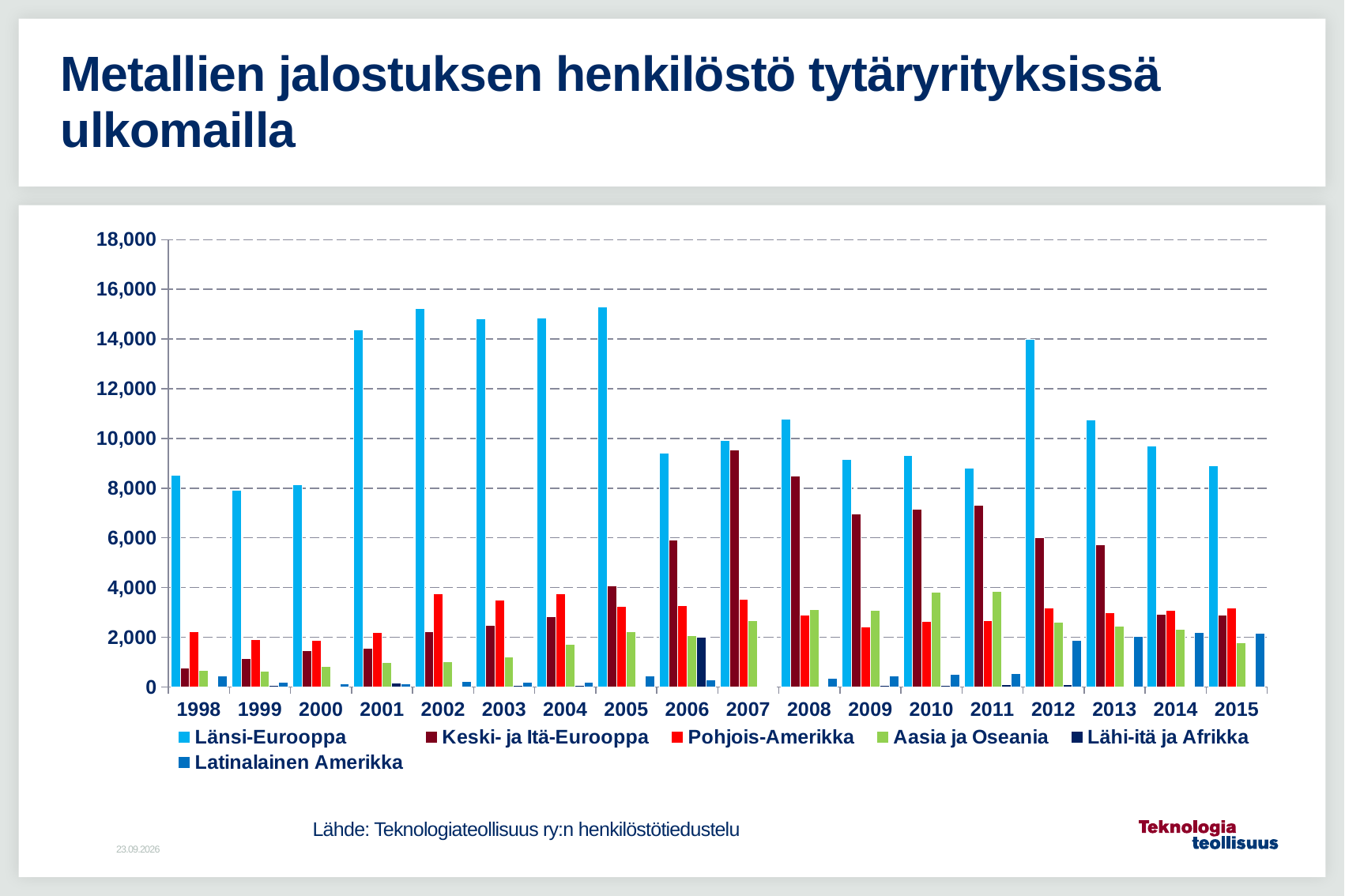
In which year is the value for Keski- ja Itä-Eurooppa highest? 2007 How many years are shown on the x axis? 18 What colour represents Länsi-Eurooppa in the legend? Light blue What kind of chart is shown on the slide? Bar chart Is the value for Pohjois-Amerikka in 1998 greater or less than 4,000? less Is the value for Länsi-Eurooppa in 2002 greater or less than 14,000? greater Which is larger for Länsi-Eurooppa: the value in 2005 or in 2006? 2005 Is the value for Länsi-Eurooppa in 2008 greater or less than 10,000? greater How many series does the legend list? 6 Which is larger for Länsi-Eurooppa: the value in 2012 or in 2013? 2012 In 2011, which is larger: Aasia ja Oseania or Pohjois-Amerikka? Aasia ja Oseania